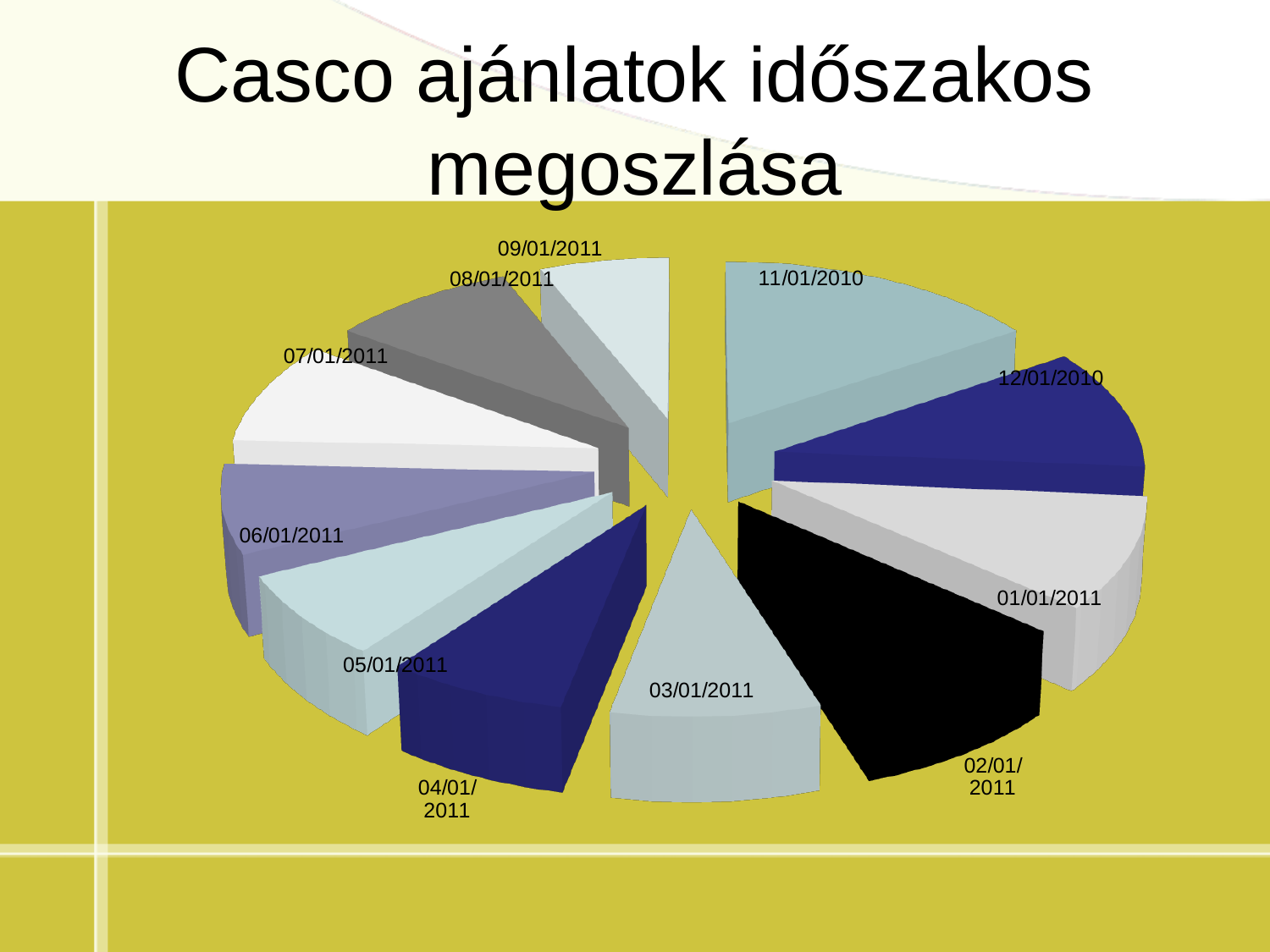
How many slices does the pie chart have? 11 Which slice is larger, 02/01/2011 or 09/01/2011? 02/01/2011 Which slice of the pie chart is coloured black? 02/01/2011 What kind of chart is shown on the slide? pie chart Which slice is larger, 11/01/2010 or 09/01/2011? 11/01/2010 What is the earliest date labelled on the pie chart? 11/01/2010 What is the latest date labelled on the pie chart? 09/01/2011 What is the title of the slide containing the pie chart? Casco ajánlatok időszakos megoszlása Which slice is larger, 12/01/2010 or 08/01/2011? 12/01/2010